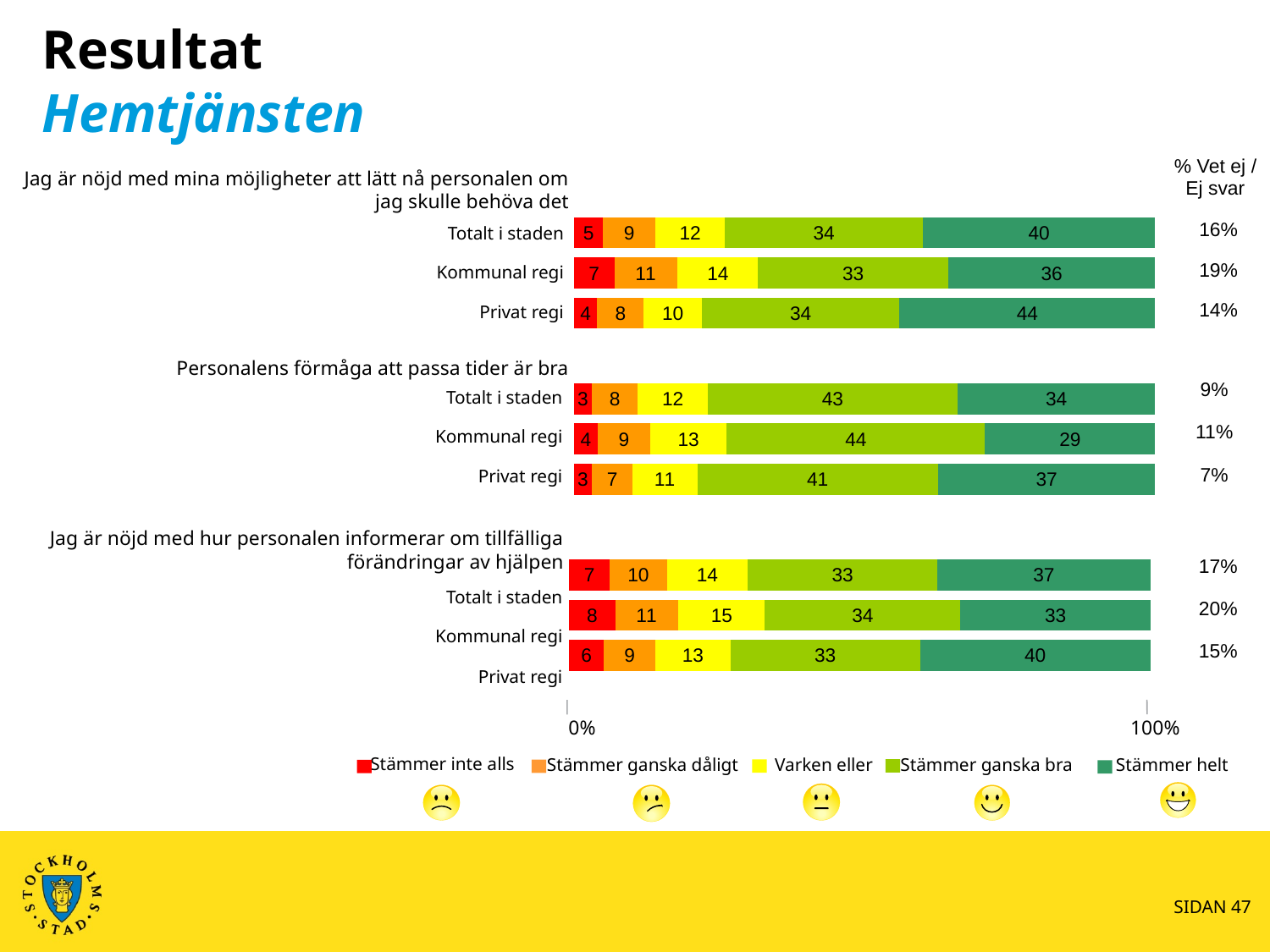
What kind of chart is shown on the slide? Stacked bar chart For the statement 'Jag är nöjd med mina möjligheter att lätt nå personalen om jag skulle behöva det', which row has the lowest 'Stämmer helt' value? Kommunal regi For the statement 'Jag är nöjd med hur personalen informerar om tillfälliga förändringar av hjälpen', what is the 'Stämmer inte alls' value for Kommunal regi? 8 For the statement 'Jag är nöjd med mina möjligheter att lätt nå personalen om jag skulle behöva det', what is the 'Stämmer helt' value for Privat regi? 44 For the statement 'Personalens förmåga att passa tider är bra', what is the difference between the 'Stämmer helt' values for Privat regi and Kommunal regi? 8 How many bars are plotted on the chart in total? 9 What is the '% Vet ej / Ej svar' value for Kommunal regi under 'Jag är nöjd med hur personalen informerar om tillfälliga förändringar av hjälpen'? 20% For the statement 'Personalens förmåga att passa tider är bra', which row has the highest 'Stämmer helt' value? Privat regi For the statement 'Jag är nöjd med hur personalen informerar om tillfälliga förändringar av hjälpen', is the 'Stämmer helt' value larger for Totalt i staden or for Privat regi? Privat regi What is the total of the Totalt i staden bar for 'Jag är nöjd med mina möjligheter att lätt nå personalen om jag skulle behöva det'? 100 For the statement 'Personalens förmåga att passa tider är bra', what is the 'Stämmer ganska bra' value for Kommunal regi? 44 How many series does the legend list? 5